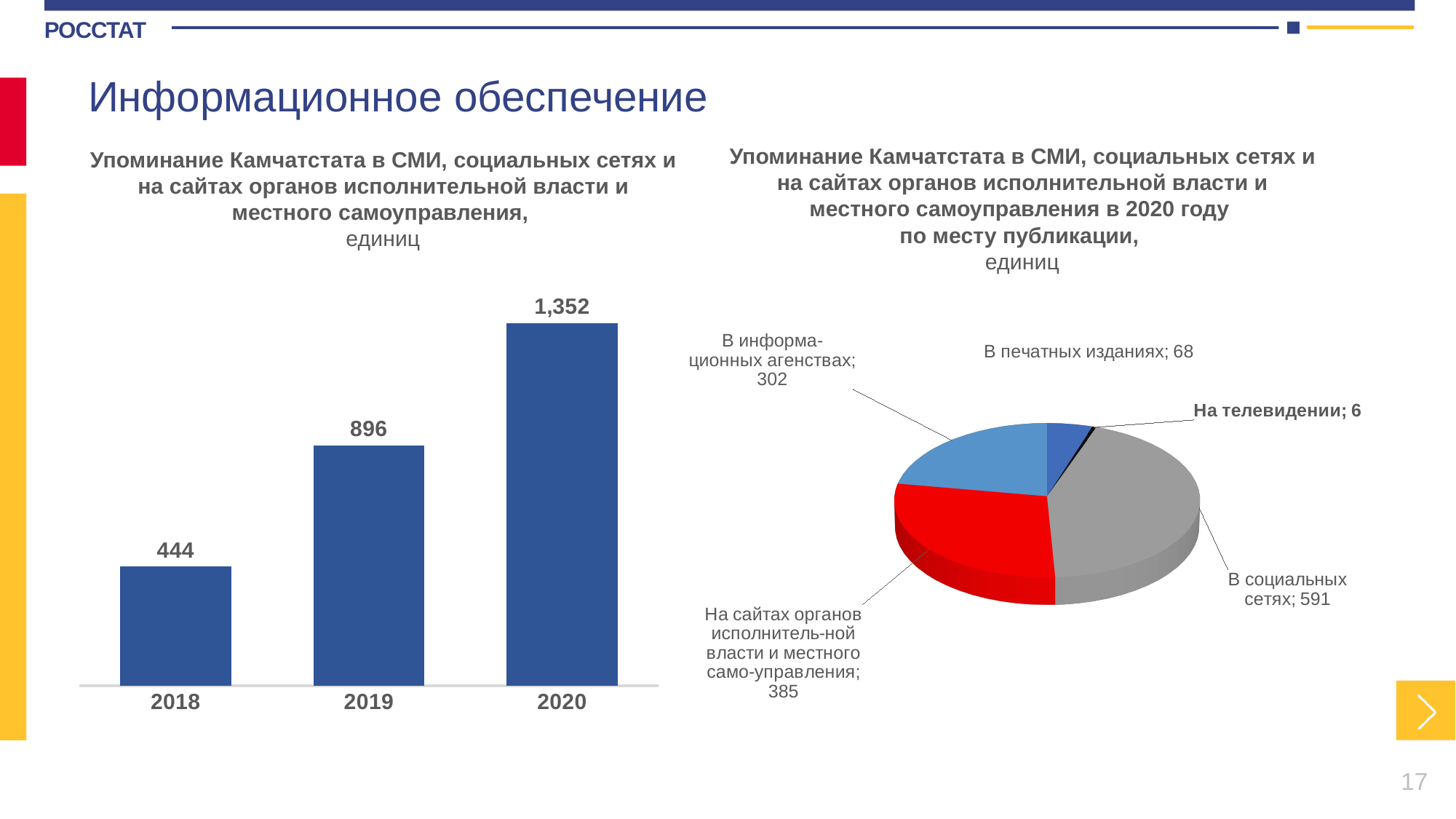
In the pie chart on the right, what is the value for 'На телевидении'? 6 In the bar chart on the left, which year has the lowest value? 2018 In the bar chart on the left, what is the value for 2020? 1,352 In the pie chart on the right, which category has the largest slice? В социальных сетях How many bars are in the bar chart on the left? 3 In the pie chart on the right, what is the value for 'В социальных сетях'? 591 In the bar chart on the left, do the values rise or fall from 2018 to 2020? rise In the bar chart on the left, what is the value for 2018? 444 What type of chart is on the left side of the slide? bar chart How many slices does the pie chart on the right have? 5 In the bar chart on the left, what is the difference between the 2020 and 2019 values? 456 In the pie chart on the right, which is larger: 'В информационных агентствах' or 'В печатных изданиях'? В информационных агентствах